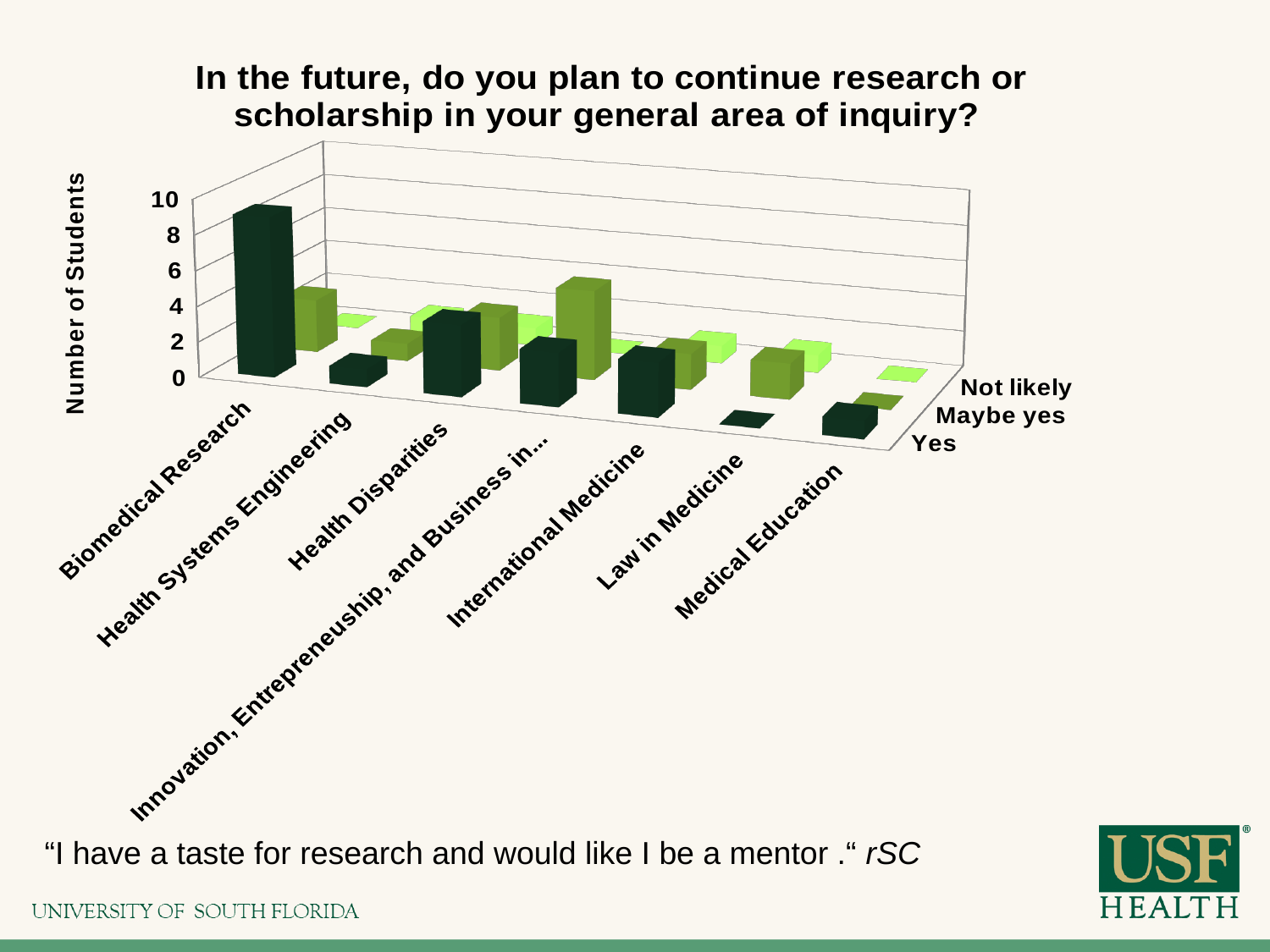
Which is larger: the 'Maybe yes' value for Innovation, Entrepreneurship, and Business in... or the 'Maybe yes' value for Law in Medicine? Innovation, Entrepreneuship, and Business in... What is the label of the vertical axis? Number of Students Which category has the highest 'Maybe yes' value? Innovation, Entrepreneuship, and Business in... Is the 'Yes' value for Law in Medicine greater or less than 2? less What kind of chart is shown on the slide? bar chart What are the three response series shown in the chart? Yes, Maybe yes, Not likely How many series does the chart show? 3 Which category has the highest 'Yes' value? Biomedical Research Which is larger: the 'Yes' value for Biomedical Research or the 'Yes' value for Health Disparities? Biomedical Research Is the 'Yes' value for Biomedical Research greater or less than 6? greater Which category has the lowest 'Yes' value? Law in Medicine How many categories (areas of inquiry) are shown on the x axis? 7